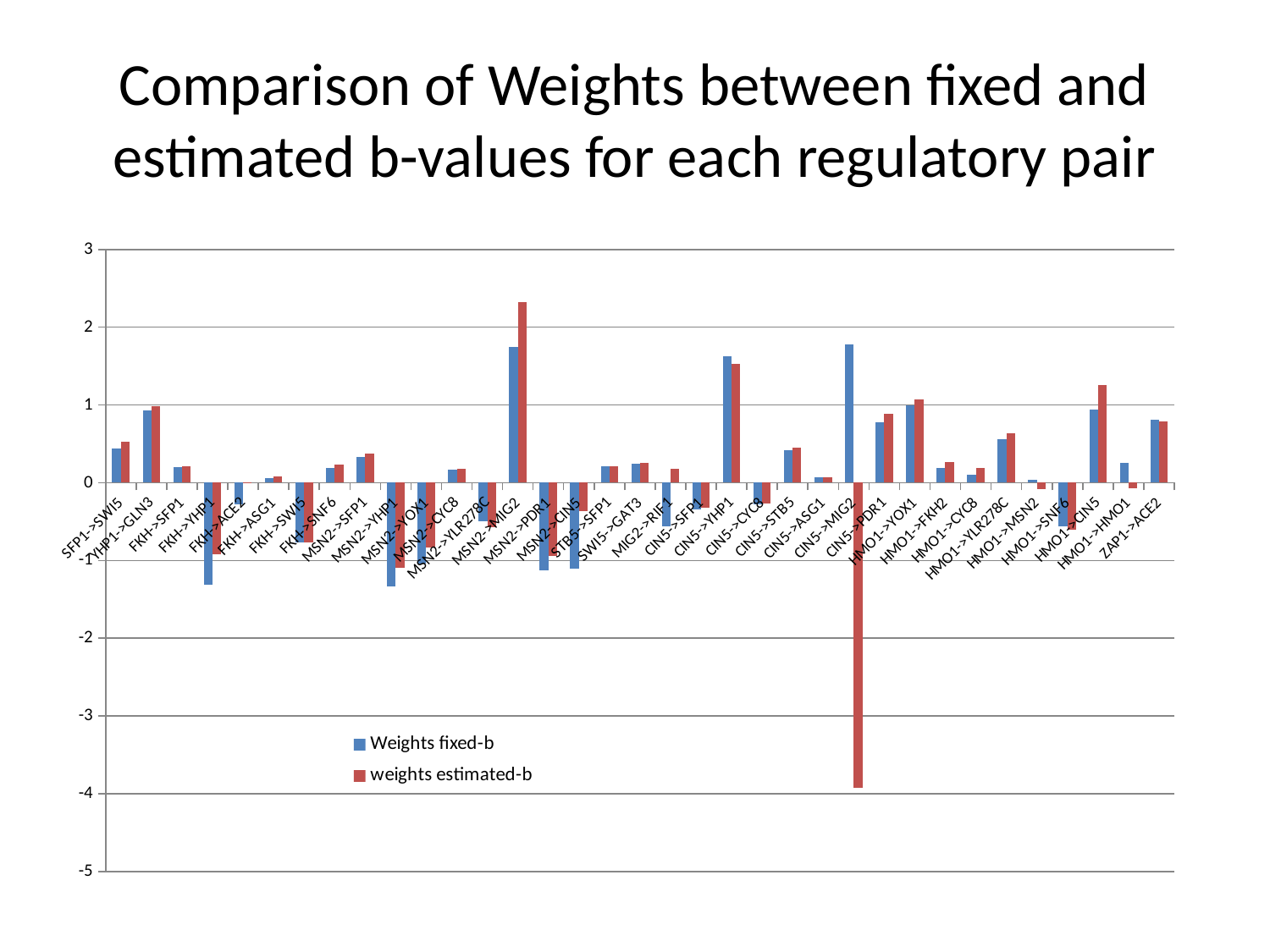
Is the weights estimated-b value for CIN5->MIG2 greater or less than -3? less Is the Weights fixed-b value for CIN5->MIG2 greater or less than 1? greater What colour are the bars for the weights estimated-b series? red Which regulatory pair has the lowest value for the weights estimated-b series? CIN5->MIG2 Which regulatory pair has the highest value for the weights estimated-b series? MSN2->MIG2 For HMO1->CIN5, which is larger: the Weights fixed-b value or the weights estimated-b value? weights estimated-b For MSN2->MIG2, which is larger: the Weights fixed-b value or the weights estimated-b value? weights estimated-b What kind of chart is shown on the slide? bar chart Is the weights estimated-b value for MSN2->MIG2 greater or less than 2? greater How many series does the legend list? 2 What are the two series named in the legend? Weights fixed-b and weights estimated-b